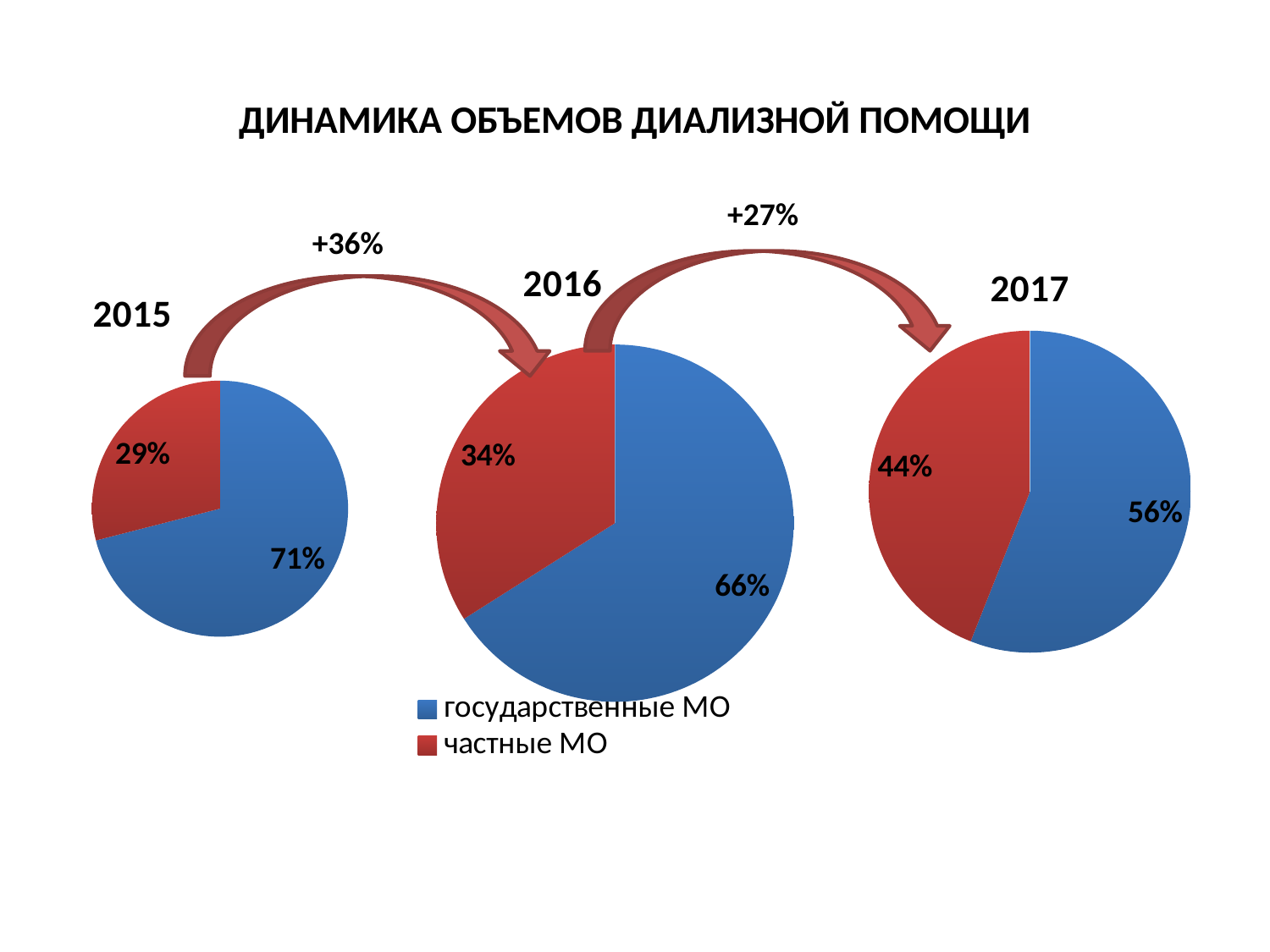
In the 2017 pie chart, what share do частные МО have? 44% In the 2015 pie chart, what share do частные МО have? 29% What kind of chart is used for each year on the slide? Pie chart What is the title of the slide? ДИНАМИКА ОБЪЕМОВ ДИАЛИЗНОЙ ПОМОЩИ In the 2017 pie chart, which category has the larger share? государственные МО In the 2016 pie chart, what share do частные МО have? 34% In the 2015 pie chart, what share do государственные МО have? 71% How many pie charts are shown on the slide? 3 How many categories does the legend list? 2 In the 2015 pie chart, what is the difference between the shares of государственные МО and частные МО? 42% In the 2017 pie chart, what share do государственные МО have? 56% In the 2016 pie chart, what share do государственные МО have? 66%